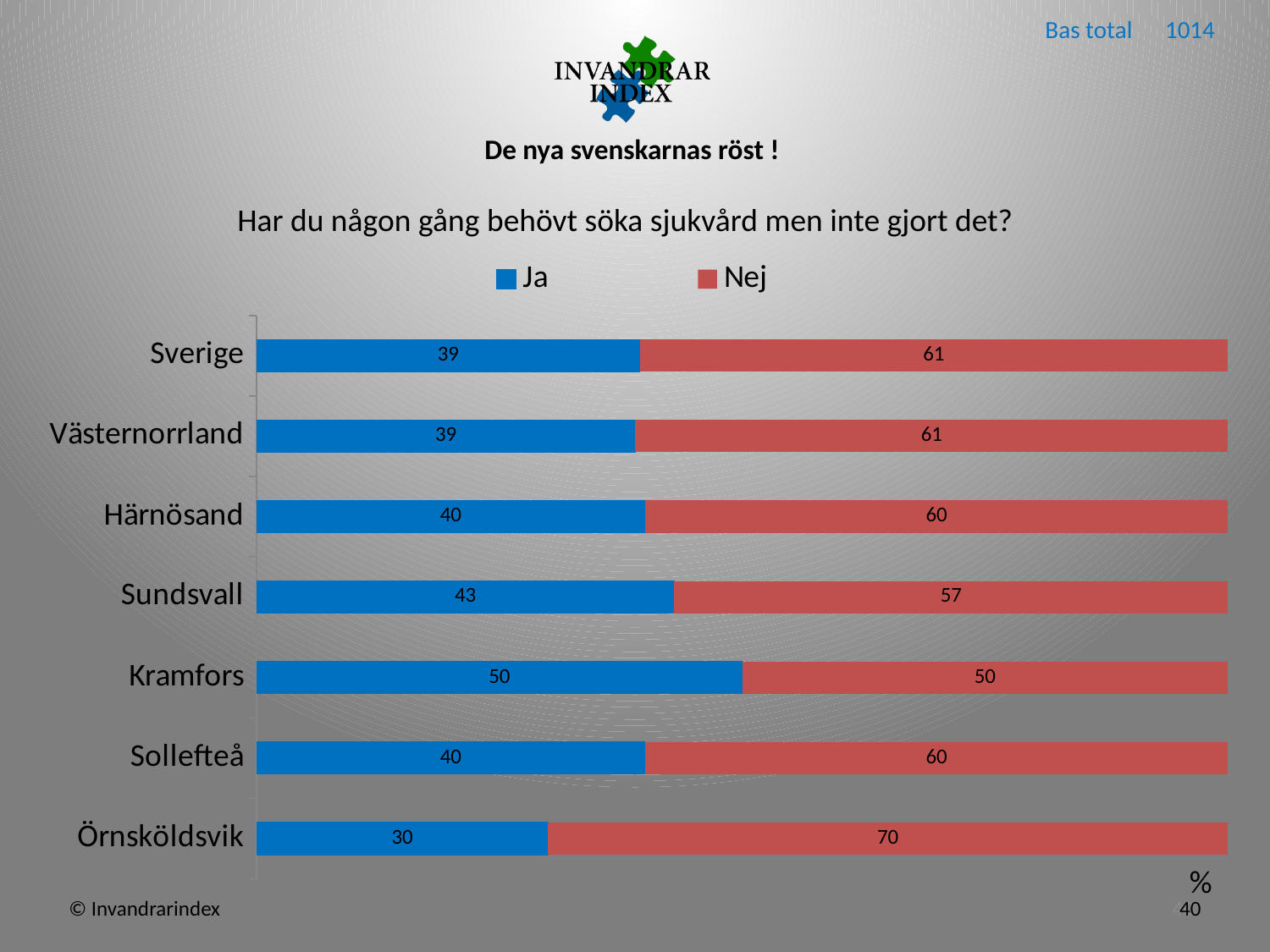
How many categories are shown on the chart? 7 What is the "Ja" value for Kramfors? 50 What are the two series named in the legend? Ja and Nej What is the "Ja" value for Sundsvall? 43 Which category has the highest "Ja" value? Kramfors What is the total of the stacked bar for Sverige? 100 What kind of chart is shown on the slide? Stacked bar chart Which is larger: the "Ja" value for Sundsvall or the "Ja" value for Härnösand? Sundsvall What is the "Nej" value for Örnsköldsvik? 70 Which category has the lowest "Ja" value? Örnsköldsvik What is the difference between the "Nej" value for Örnsköldsvik and the "Nej" value for Sundsvall? 13 How many series does the legend list? 2